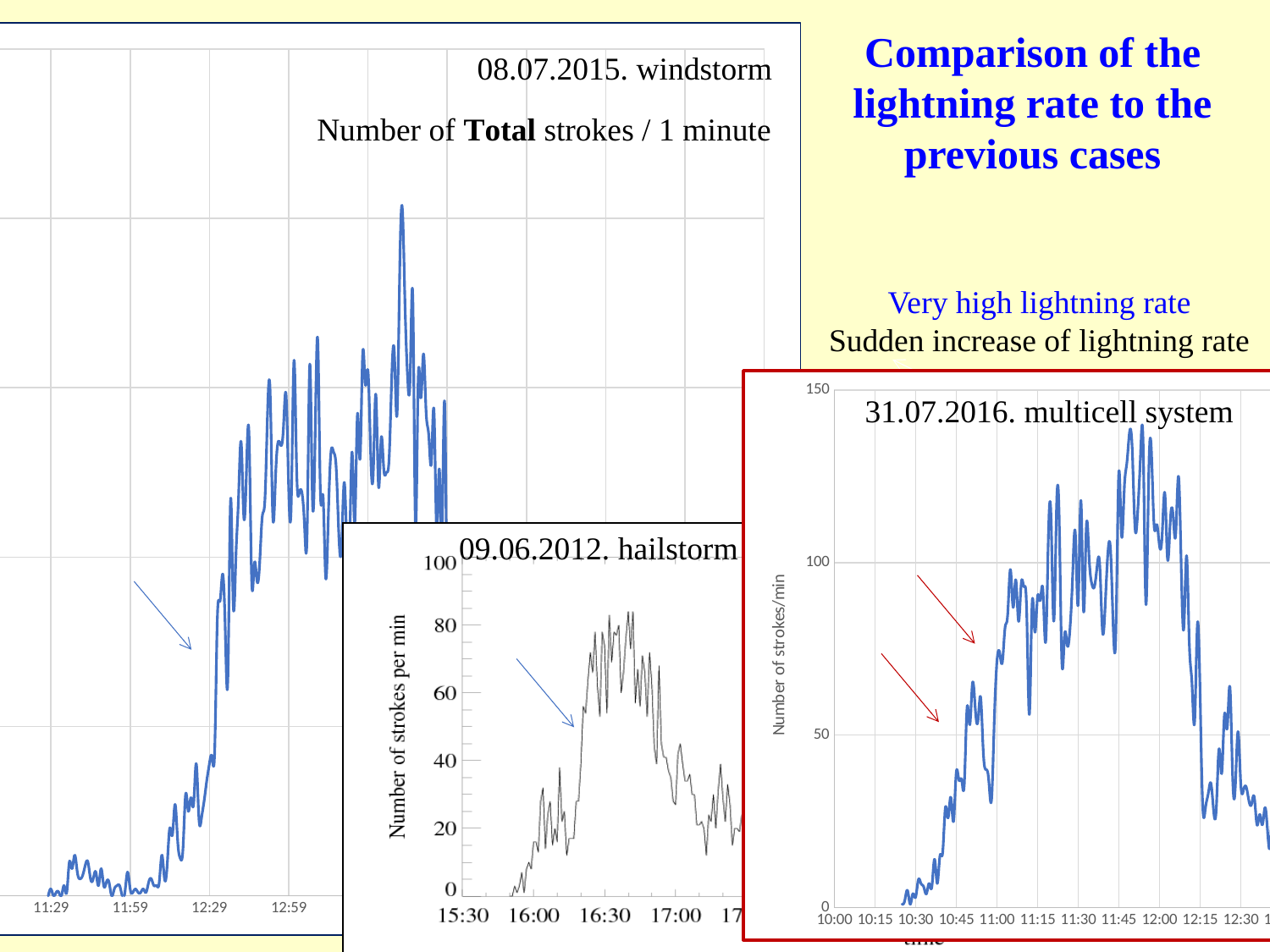
In the "09.06.2012. hailstorm" chart, is the peak value greater or less than 60? greater Which chart reaches a higher peak, the "09.06.2012. hailstorm" chart or the "31.07.2016. multicell system" chart? 31.07.2016. multicell system What kind of chart is the "09.06.2012. hailstorm" chart? line chart In the "31.07.2016. multicell system" chart, do the values rise or fall between 10:30 and 11:45? rise How many charts are shown on the slide? 3 In the "31.07.2016. multicell system" chart, is the peak value greater or less than 100? greater In the "09.06.2012. hailstorm" chart, is the value at 16:00 greater or less than 40? less In the "31.07.2016. multicell system" chart, do the values rise or fall between 12:00 and 12:30? fall What kind of chart is the "31.07.2016. multicell system" chart? line chart What is the highest y-axis tick value shown on the "31.07.2016. multicell system" chart? 150 What is the y-axis label of the "09.06.2012. hailstorm" chart? Number of strokes per min